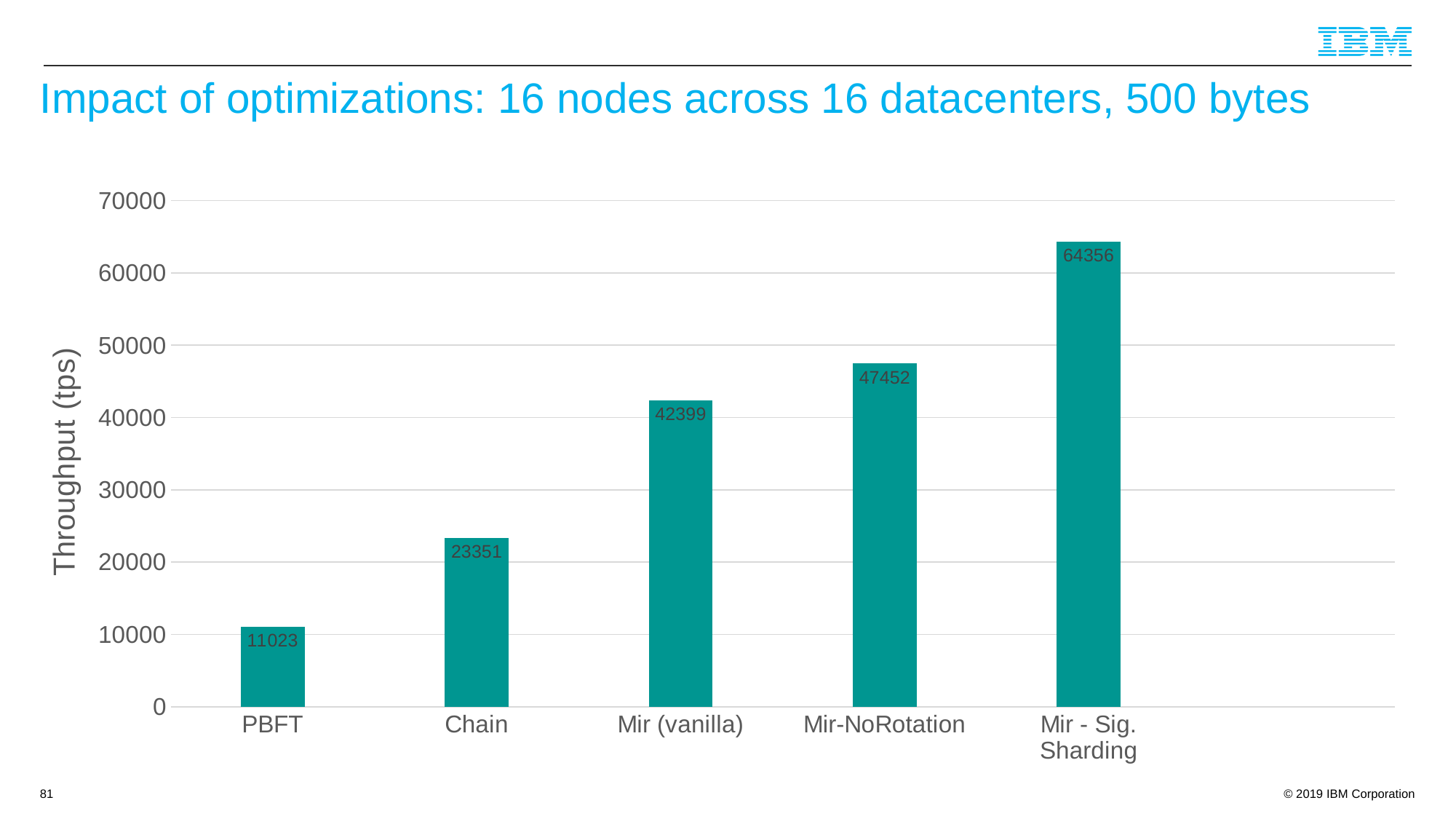
What is the throughput (tps) for PBFT? 11023 Which has a higher throughput, Chain or Mir (vanilla)? Mir (vanilla) What is the throughput (tps) for Chain? 23351 What is the label of the y axis? Throughput (tps) Is the throughput for Mir - Sig. Sharding greater or less than 60000? greater Which category has the lowest throughput? PBFT How many categories are shown on the x axis? 5 What is the throughput (tps) for Mir (vanilla)? 42399 What is the throughput (tps) for Mir-NoRotation? 47452 Which category has the highest throughput? Mir - Sig. Sharding What is the difference in throughput between Mir - Sig. Sharding and Mir-NoRotation? 16904 What kind of chart is shown on the slide? Bar chart